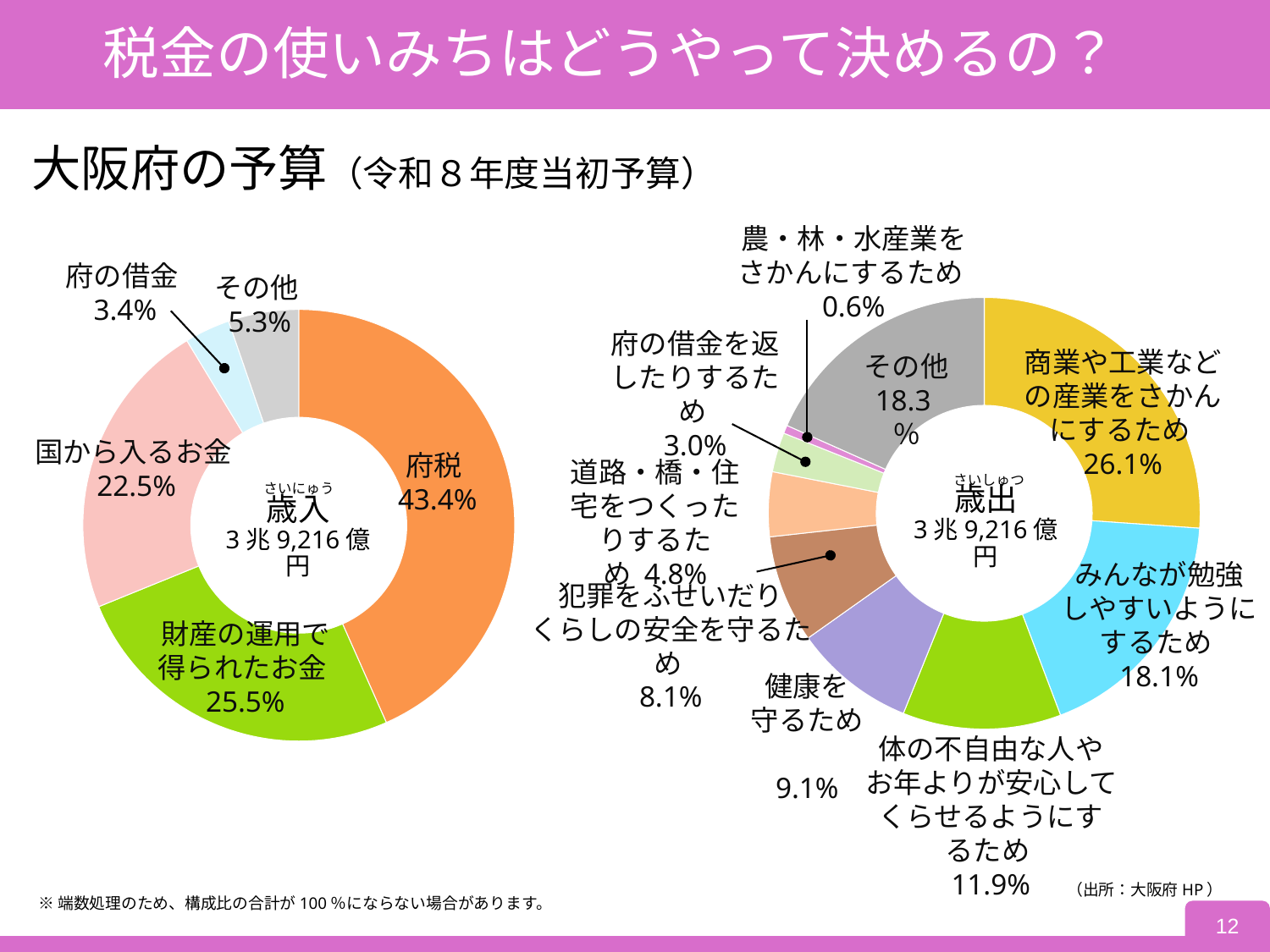
左の「歳入」のグラフには、いくつの項目がありますか？ 5 このスライドのグラフはどの種類のグラフですか？ 円グラフ（ドーナツグラフ） 右の「歳出」のグラフで、健康を守るための割合は何%ですか？ 9.1% 左の「歳入」のグラフで、府税の割合は何%ですか？ 43.4% 左の「歳入」のグラフで、国から入るお金の割合は何%ですか？ 22.5% 右の「歳出」のグラフで、最も割合が小さい項目はどれですか？ 農・林・水産業をさかんにするため 左の「歳入」のグラフで、最も割合が小さい項目はどれですか？ 府の借金 右の「歳出」のグラフで、商業や工業などの産業をさかんにするための割合は何%ですか？ 26.1% 左の「歳入」のグラフで、財産の運用で得られたお金と国から入るお金の割合の差は何ポイントですか？ 3.0ポイント 左の「歳入」のグラフで、最も割合が大きい項目はどれですか？ 府税 右の「歳出」のグラフには、いくつの項目がありますか？ 9 右の「歳出」のグラフで、みんなが勉強しやすいようにするためとその他では、どちらの割合が大きいですか？ その他